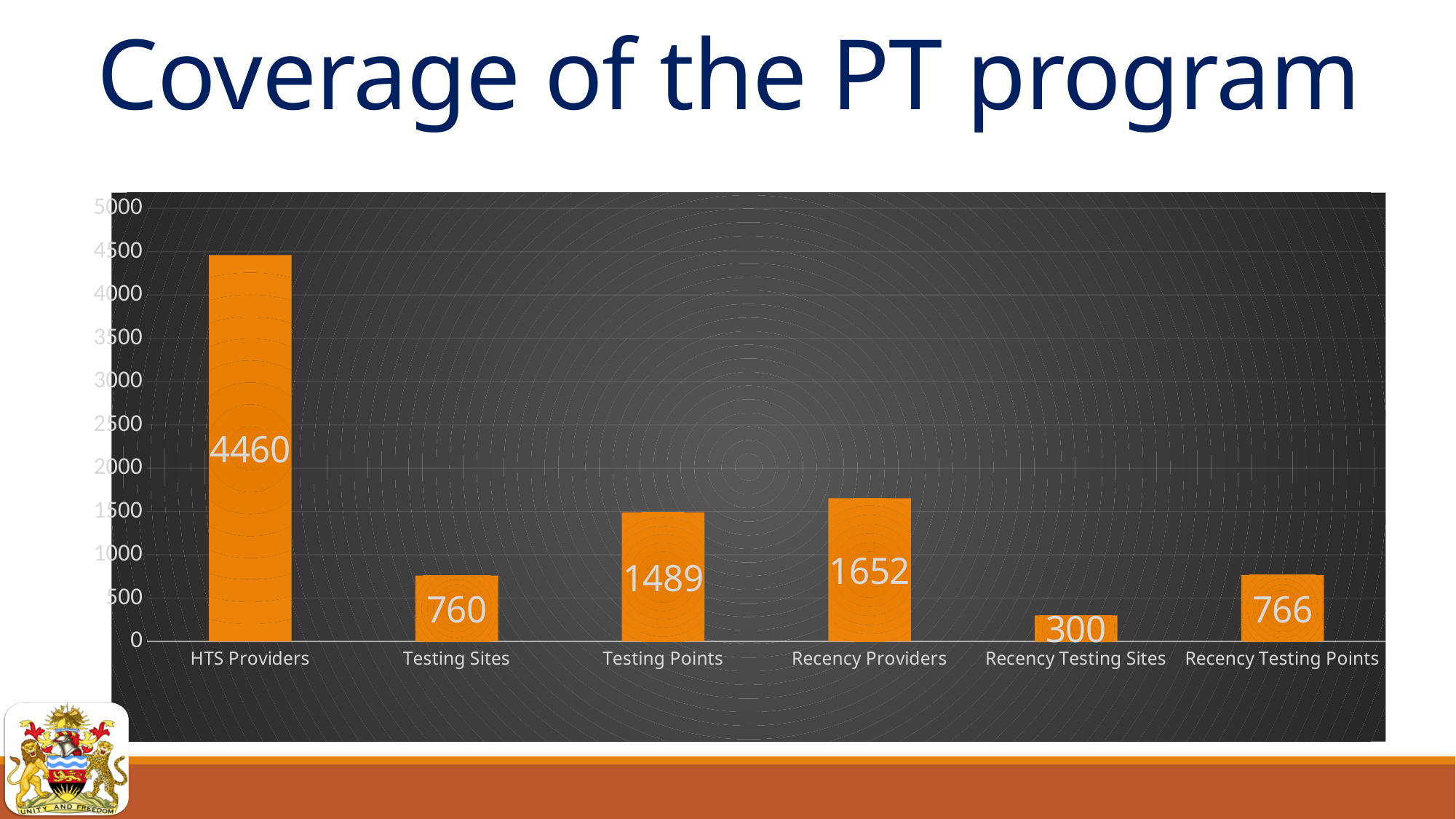
Which is larger, the value for Recency Providers or the value for Testing Points? Recency Providers What is the value for Testing Points? 1489 Which category has the highest value? HTS Providers How many categories are shown on the x axis? 6 Is the value for Testing Sites greater or less than 1000? less What is the value for Recency Testing Sites? 300 What is the difference between the values for Recency Testing Points and Testing Sites? 6 What is the value for HTS Providers? 4460 Which category has the lowest value? Recency Testing Sites What is the difference between the values for HTS Providers and Recency Providers? 2808 What kind of chart is shown on the slide? Bar chart What is the value for Recency Providers? 1652